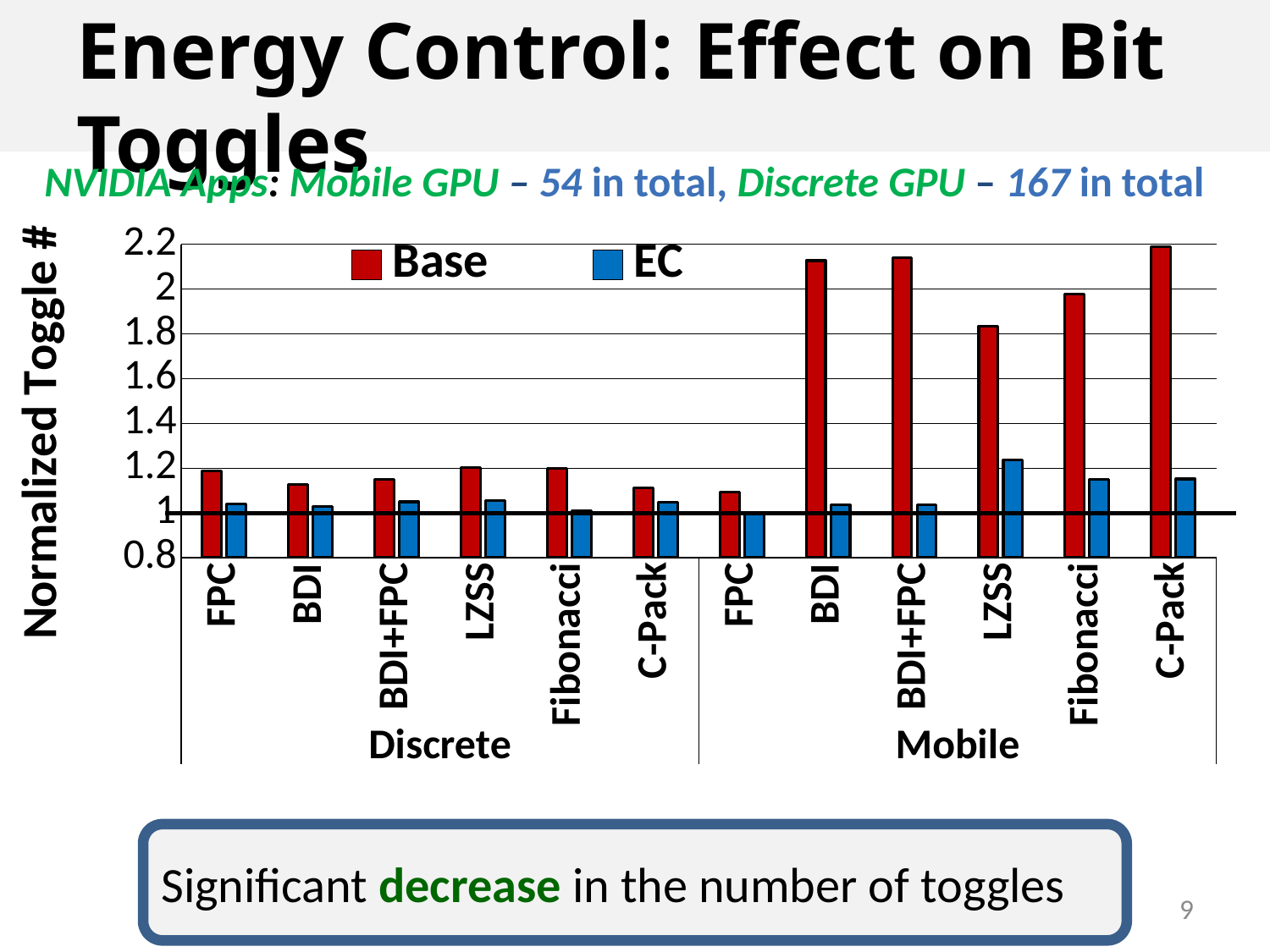
How many bar groups (categories) are plotted in total across Discrete and Mobile? 12 Is the Base value for LZSS in the Mobile group greater or less than 2? less How many compression algorithms are shown in the Mobile group? 6 What is the label of the y-axis? Normalized Toggle # Is the Base value for BDI in the Mobile group greater or less than 2? greater Which category has the highest EC value? LZSS (Mobile) Which is larger, the Base value for BDI in the Mobile group or the Base value for BDI in the Discrete group? BDI in the Mobile group Which is larger, the EC value for LZSS in the Mobile group or the EC value for LZSS in the Discrete group? LZSS in the Mobile group How many series does the legend list? 2 What kind of chart is shown on the slide? bar chart Which category has the highest Base value? C-Pack (Mobile) Is the Base value for FPC in the Discrete group greater or less than 1.4? less